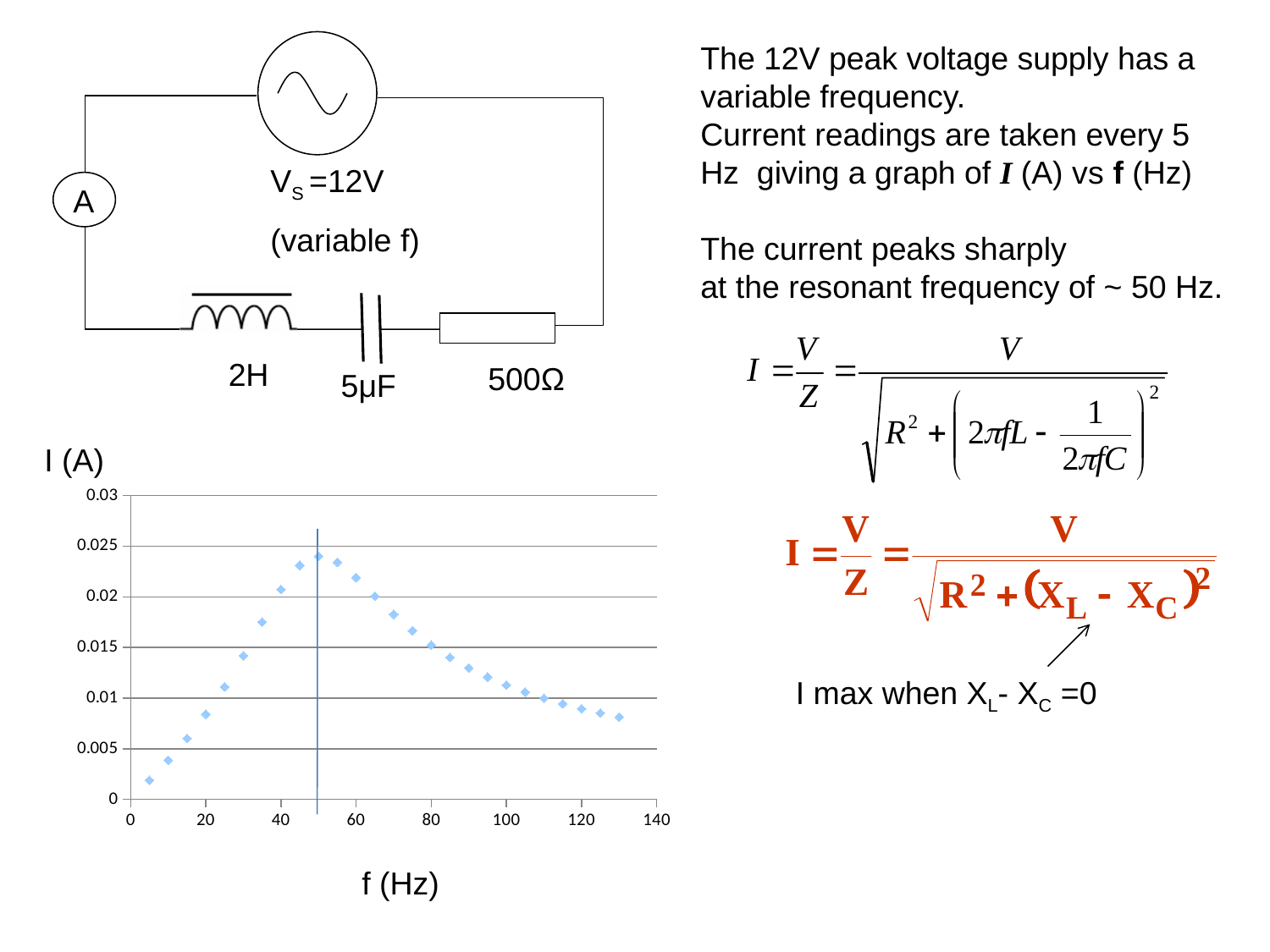
What is the label on the vertical axis of the chart? I (A) At which frequency is the plotted current lowest? 5 Hz Which has the larger current, 20 Hz or 50 Hz? 50 Hz Is the current at 5 Hz greater or less than 0.005 A? less Is the current at 50 Hz greater or less than 0.02 A? greater What kind of chart is shown on the slide? scatter chart At which frequency does the current reach its highest value on the chart? 50 Hz Is the current at 130 Hz greater or less than 0.01 A? less Which has the larger current, 30 Hz or 100 Hz? 30 Hz Does the current rise or fall as frequency increases from 50 Hz to 130 Hz? fall What is the highest value shown on the x axis of the chart? 140